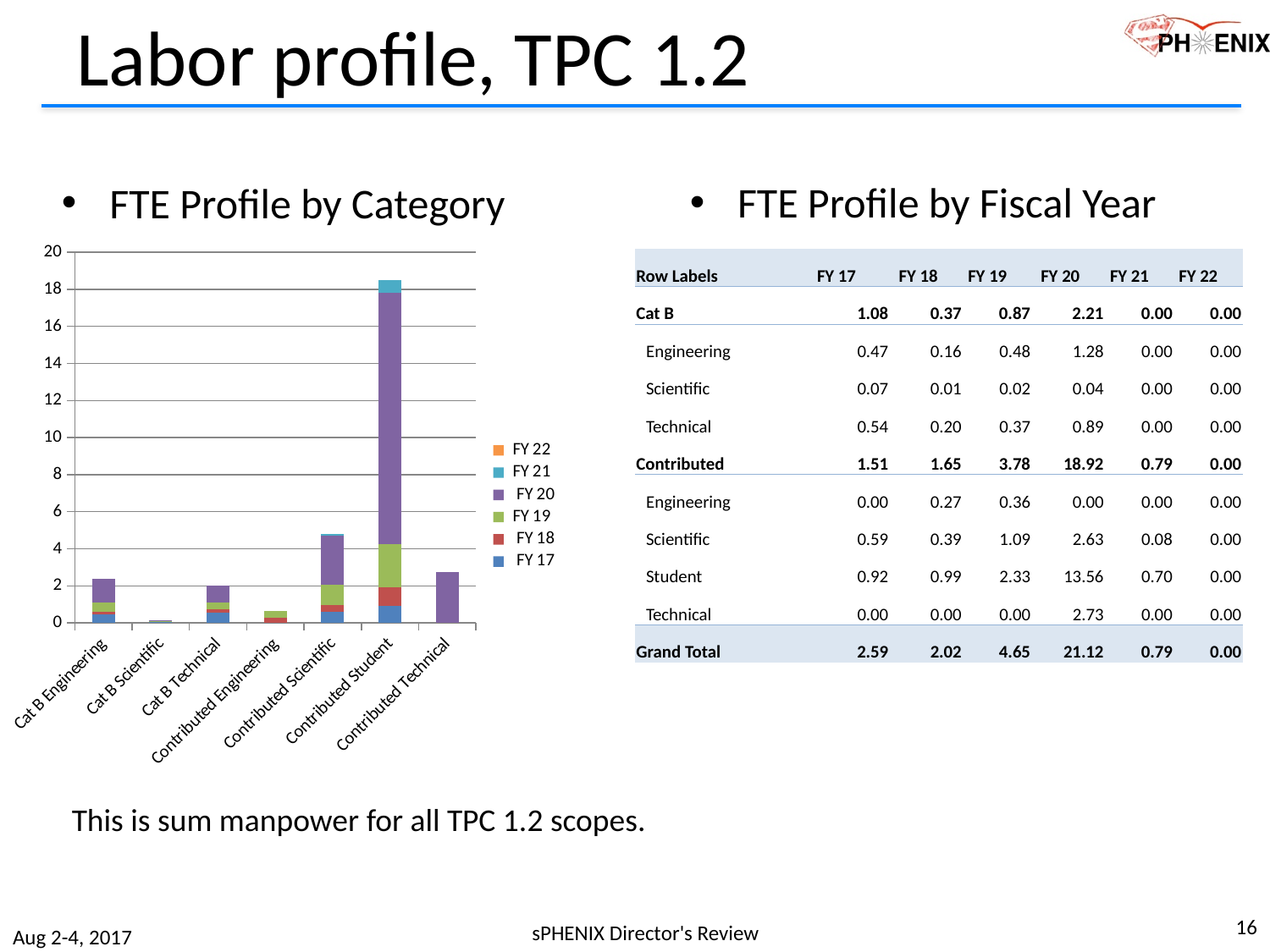
Which category has the shortest stacked bar in the chart? Cat B Scientific Which has the larger stacked bar, Cat B Engineering or Cat B Scientific? Cat B Engineering Which has the larger stacked bar, Contributed Scientific or Contributed Technical? Contributed Scientific Which fiscal year series is shown in purple in the chart's legend? FY 20 Is the total stacked value for Contributed Scientific greater or less than 6? less How many series does the chart's legend list? 6 Is the total stacked value for Contributed Technical greater or less than 4? less Is the total stacked value for Contributed Student greater or less than 16? greater What kind of chart is shown on the slide? stacked bar chart Which category has the tallest stacked bar in the chart? Contributed Student How many categories are shown on the x axis of the chart? 7